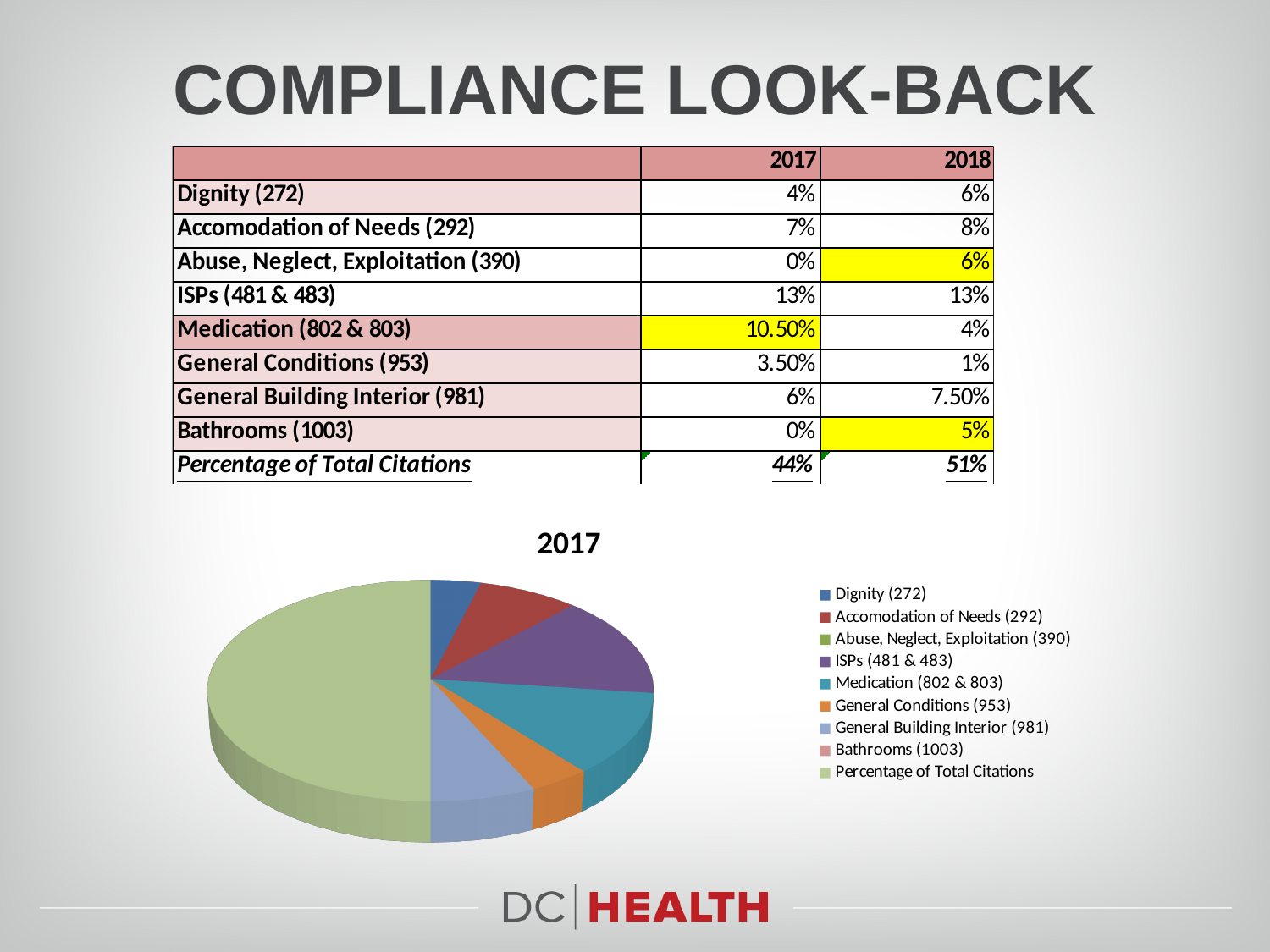
According to the slide, what is the difference between the 2017 values for ISPs (481 & 483) and Dignity (272)? 9% According to the slide, what is the 2017 value for ISPs (481 & 483) plotted in the pie chart? 13% What colour is the largest slice of the 2017 pie chart? light green How many entries does the pie chart's legend list? 9 Which category has the largest slice in the 2017 pie chart? Percentage of Total Citations In the 2017 pie chart, which slice is larger: Accomodation of Needs (292) or General Building Interior (981)? Accomodation of Needs (292) In the 2017 pie chart, which slice is larger: ISPs (481 & 483) or Dignity (272)? ISPs (481 & 483) What kind of chart is shown on the slide? pie chart According to the slide, what is the 2017 value for Percentage of Total Citations plotted in the pie chart? 44% In the 2017 pie chart, which slice is larger: Medication (802 & 803) or General Conditions (953)? Medication (802 & 803) According to the slide, what is the 2017 value for Medication (802 & 803) plotted in the pie chart? 10.50% What is the title of the pie chart? 2017